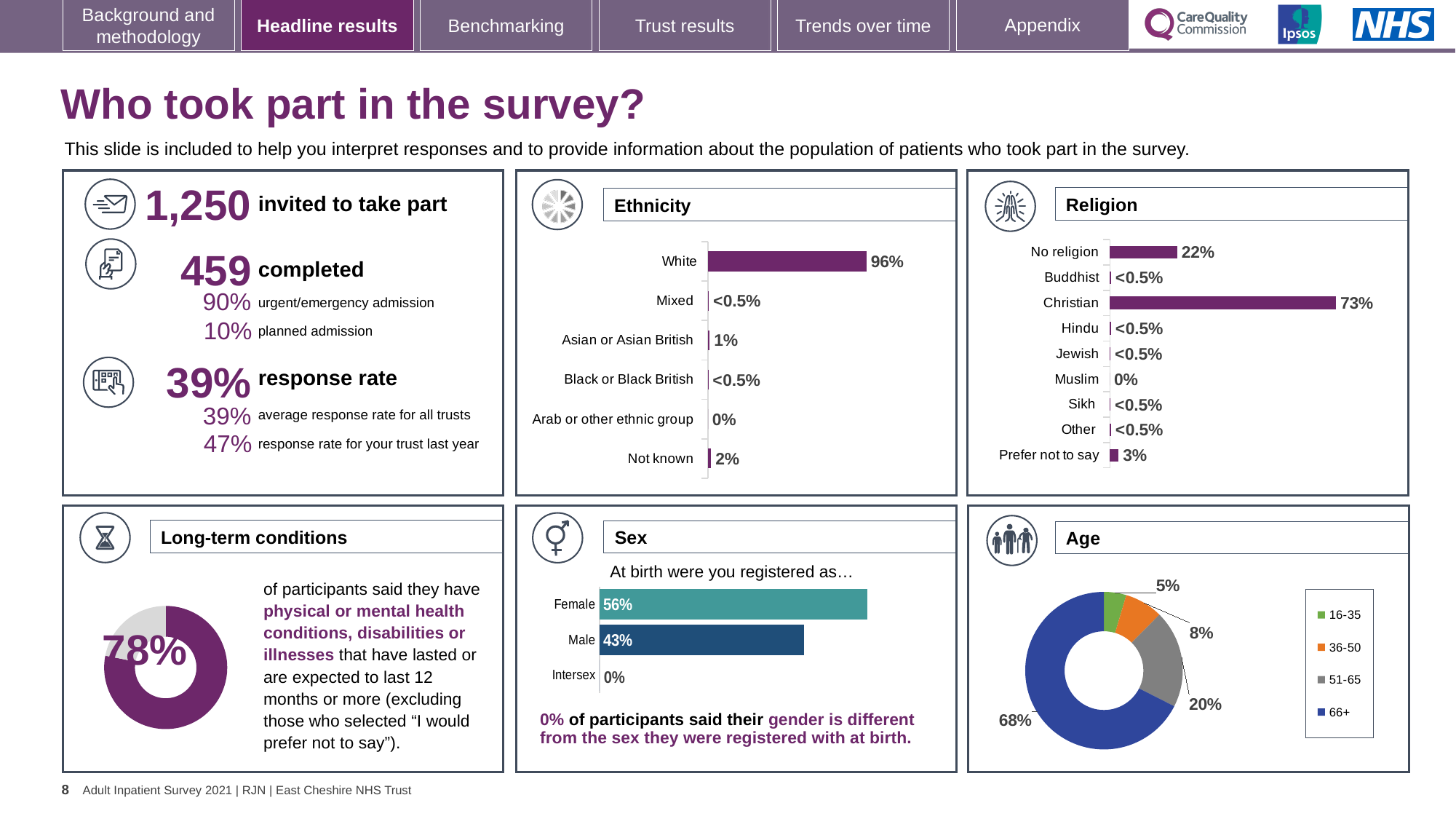
In the Age chart, which age group has the smallest share? 16-35 In the Ethnicity chart, which category has the highest value? White In the Age chart, what share of participants were aged 66+? 68% In the Sex chart, what percentage of participants were registered as Female at birth? 56% In the Religion chart, what is the value for Prefer not to say? 3% In the Religion chart, what percentage of participants were Christian? 73% What kind of chart is used for the Age breakdown? Doughnut chart In the Ethnicity chart, what percentage of participants were White? 96% In the Sex chart, which is larger, Female or Male? Female In the Ethnicity chart, what is the value for Not known? 2% How many categories are shown in the Ethnicity chart? 6 In the Religion chart, what is the difference between the Christian and No religion values? 51%